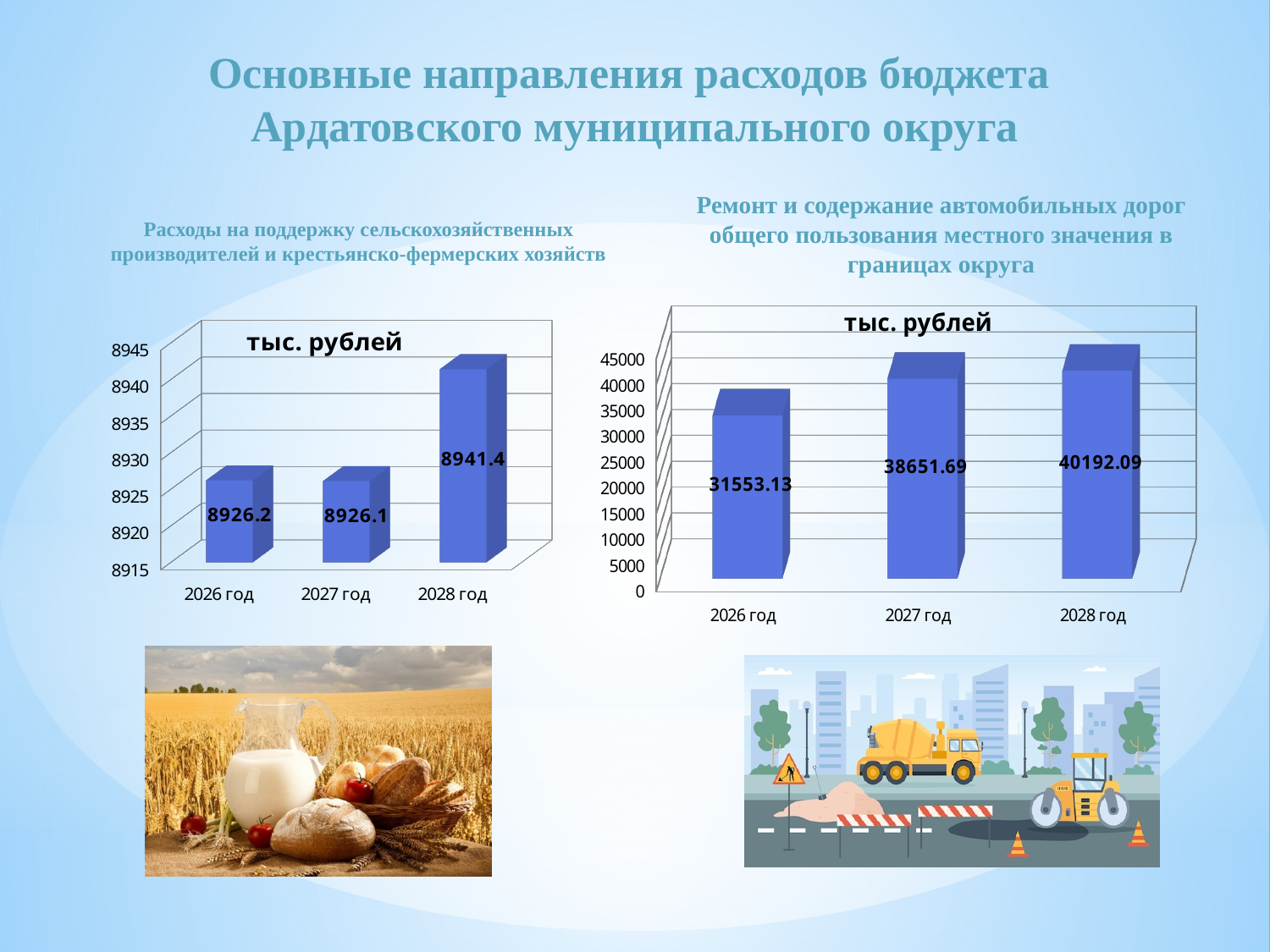
On the right chart, what is the value for 2027 год? 38651.69 On the right chart, do the values rise or fall from 2026 год to 2028 год? rise On the right chart, which year has the lowest value? 2026 год On the right chart, what is the value for 2026 год? 31553.13 What kind of chart is the right chart? bar chart On the left chart, what is the value for 2028 год? 8941.4 On the right chart, which is larger, the value for 2027 год or 2026 год? 2027 год On the left chart, what is the difference between the values for 2028 год and 2026 год? 15.2 On the left chart, which year has the highest value? 2028 год On the right chart, what is the difference between the values for 2028 год and 2026 год? 8638.96 On the left chart, what is the value for 2026 год? 8926.2 On the right chart, is the value for 2026 год greater or less than 35000? less